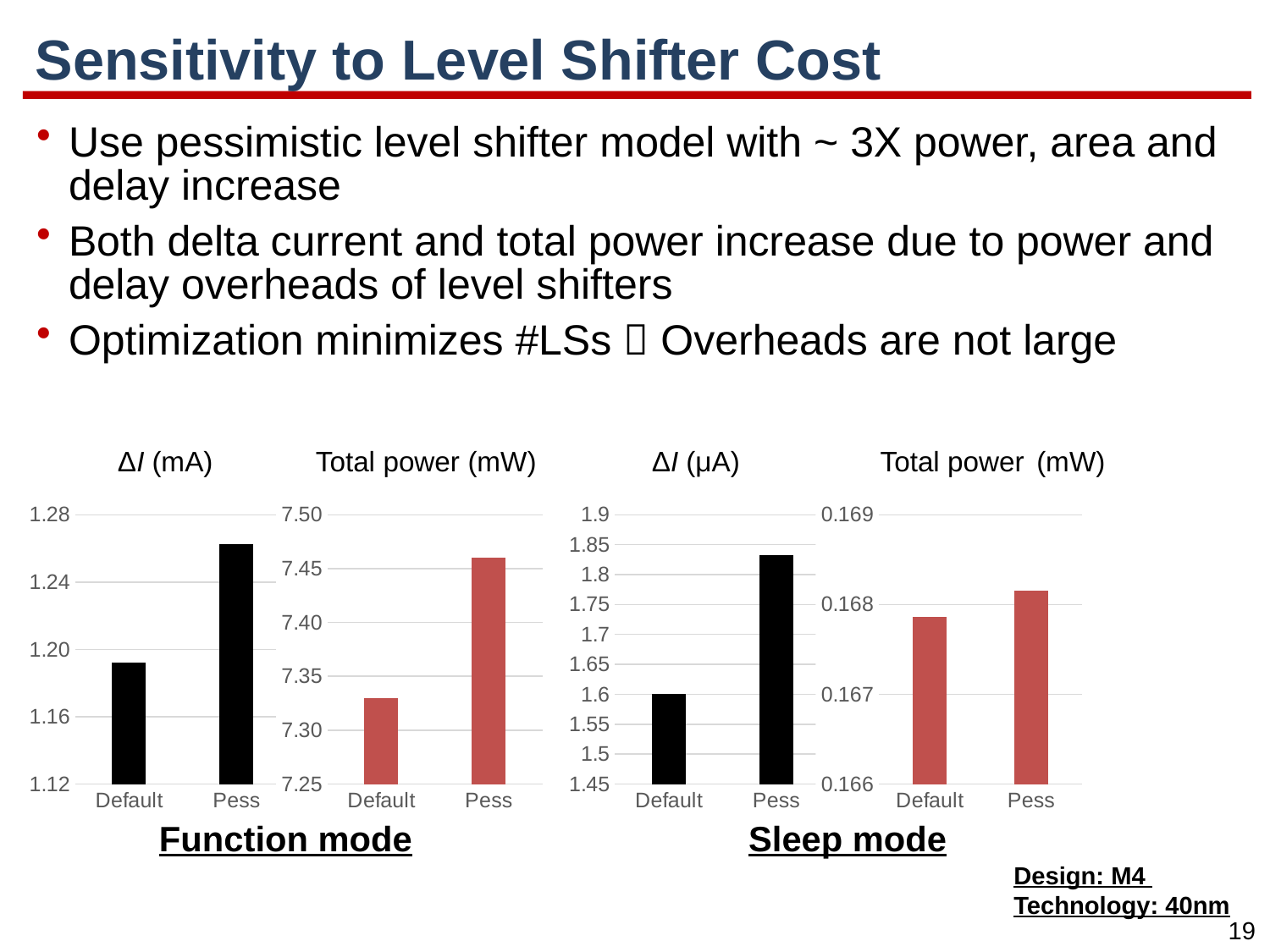
In the Sleep mode Total power (mW) chart, which category has the lowest value? Default In the Sleep mode ΔI (µA) chart, is the value for Pess greater or less than 1.8? greater In the Function mode ΔI (mA) chart, is the value for Pess greater or less than 1.24? greater In the Function mode ΔI (mA) chart, is the value for Default greater or less than 1.20? less In the Function mode ΔI (mA) chart, which category has the higher value, Default or Pess? Pess How many categories are shown in the Function mode ΔI (mA) chart? 2 How many charts are shown on the slide? 4 In the Sleep mode ΔI (µA) chart, which category has the highest value? Pess What kind of chart is the Sleep mode Total power (mW) chart? bar chart